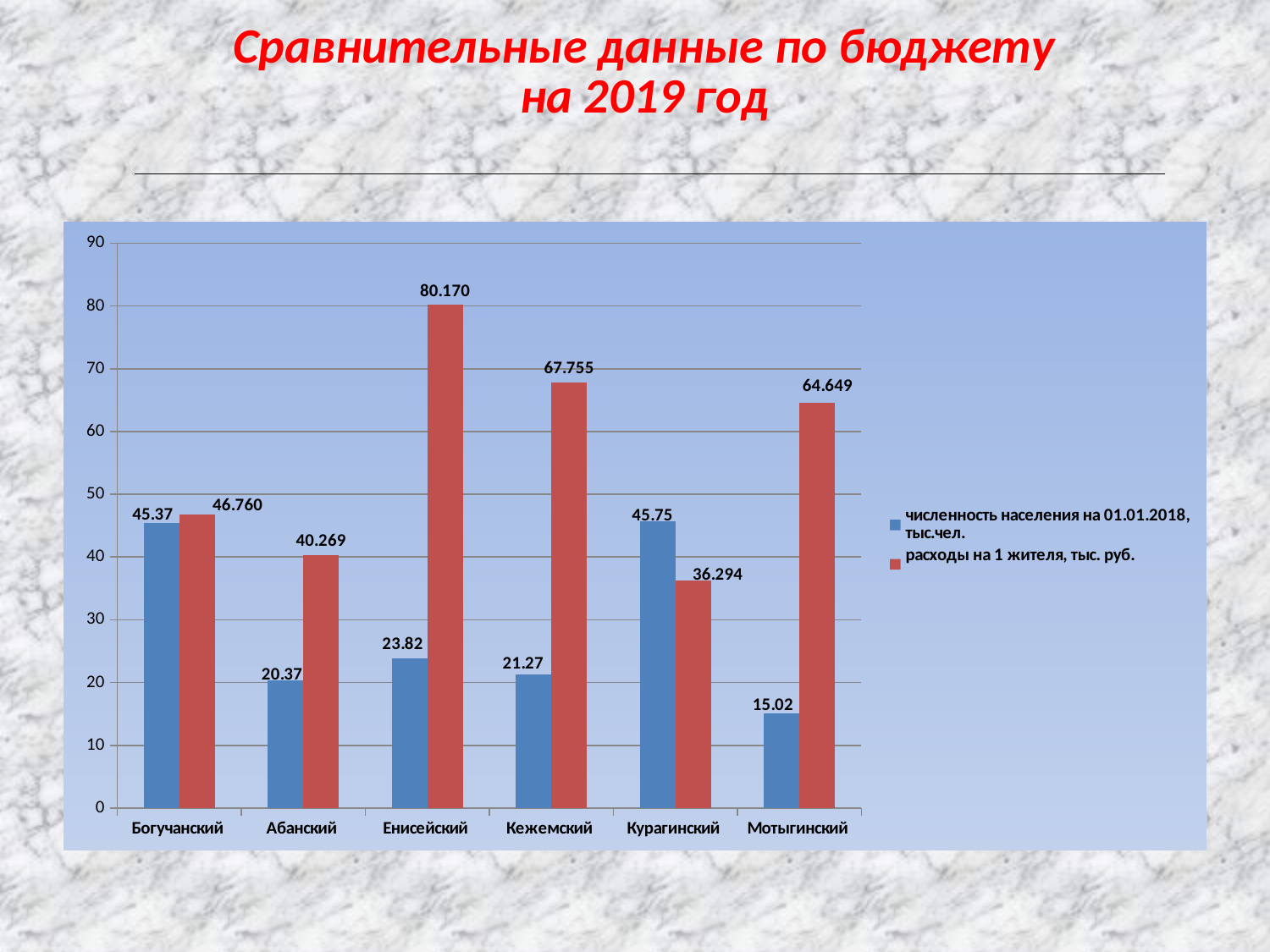
What is the value of 'расходы на 1 жителя, тыс. руб.' for Курагинский? 36.294 How many series does the legend list? 2 How many districts (categories) are shown on the x axis? 6 What is the difference between 'расходы на 1 жителя' and 'численность населения' for Енисейский? 56.35 What type of chart is shown on the slide? bar chart For Курагинский, which is larger: 'численность населения на 01.01.2018, тыс.чел.' or 'расходы на 1 жителя, тыс. руб.'? численность населения на 01.01.2018, тыс.чел. Which district has the lowest value for 'расходы на 1 жителя, тыс. руб.'? Курагинский What is the value of 'численность населения на 01.01.2018, тыс.чел.' for Мотыгинский? 15.02 What is the value of 'расходы на 1 жителя, тыс. руб.' for Енисейский? 80.170 Which district has the highest value for 'расходы на 1 жителя, тыс. руб.'? Енисейский What colour are the bars for 'расходы на 1 жителя, тыс. руб.'? red Which district has the lowest value for 'численность населения на 01.01.2018, тыс.чел.'? Мотыгинский